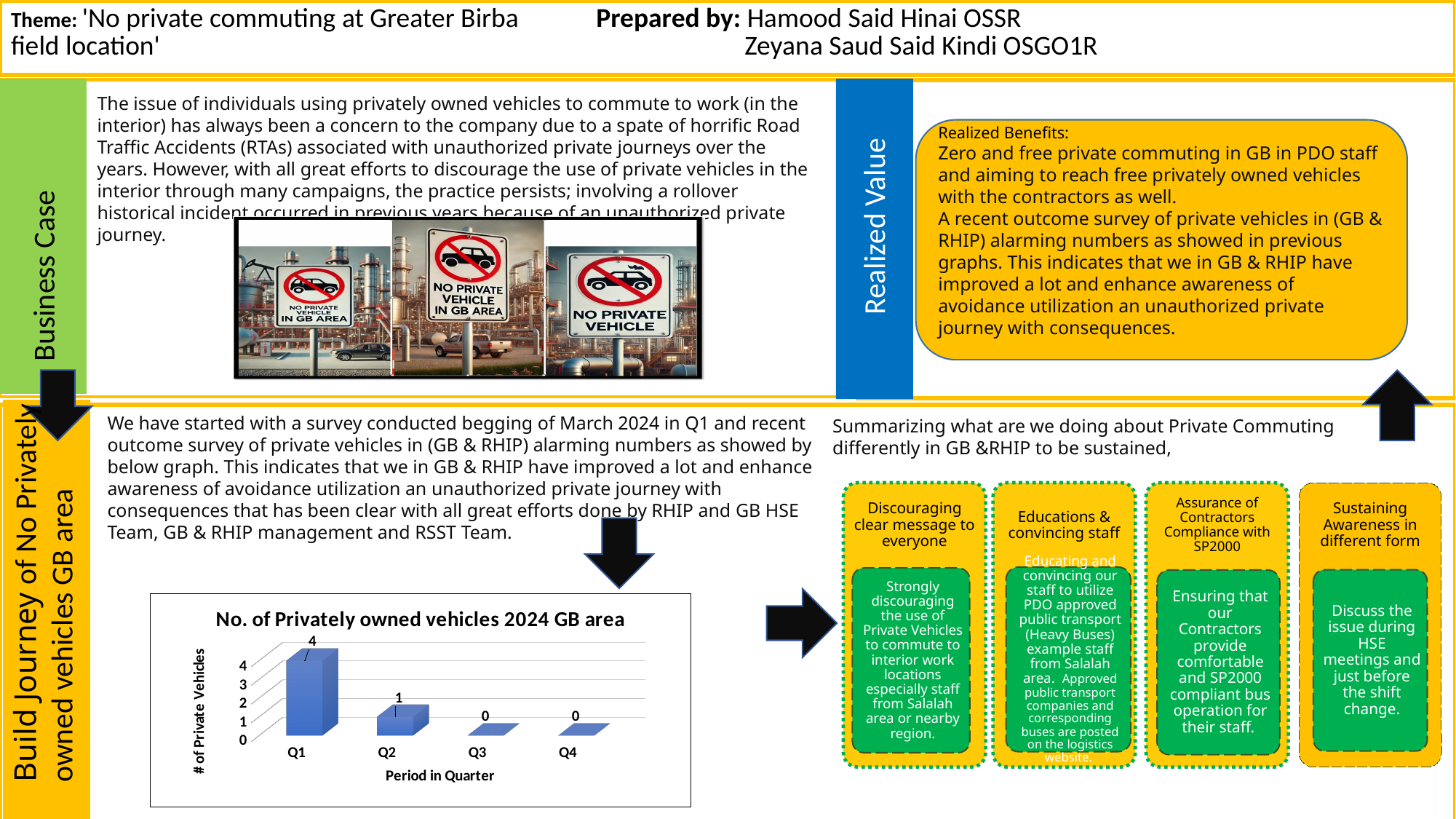
What is the value for Q3 in the chart? 0 Which quarter has the highest number of privately owned vehicles? Q1 Which is larger, the value for Q1 or the value for Q2? Q1 What is the label of the x axis of the chart? Period in Quarter What is the difference between the values for Q1 and Q2? 3 What kind of chart is shown on the slide? Bar chart Do the values rise or fall from Q1 to Q4? Fall What is the value for Q1 in the chart 'No. of Privately owned vehicles 2024 GB area'? 4 What is the title of the chart? No. of Privately owned vehicles 2024 GB area What is the value for Q2 in the chart? 1 How many quarters are shown on the x axis of the chart? 4 What is the total of the values for Q1, Q2, Q3 and Q4? 5